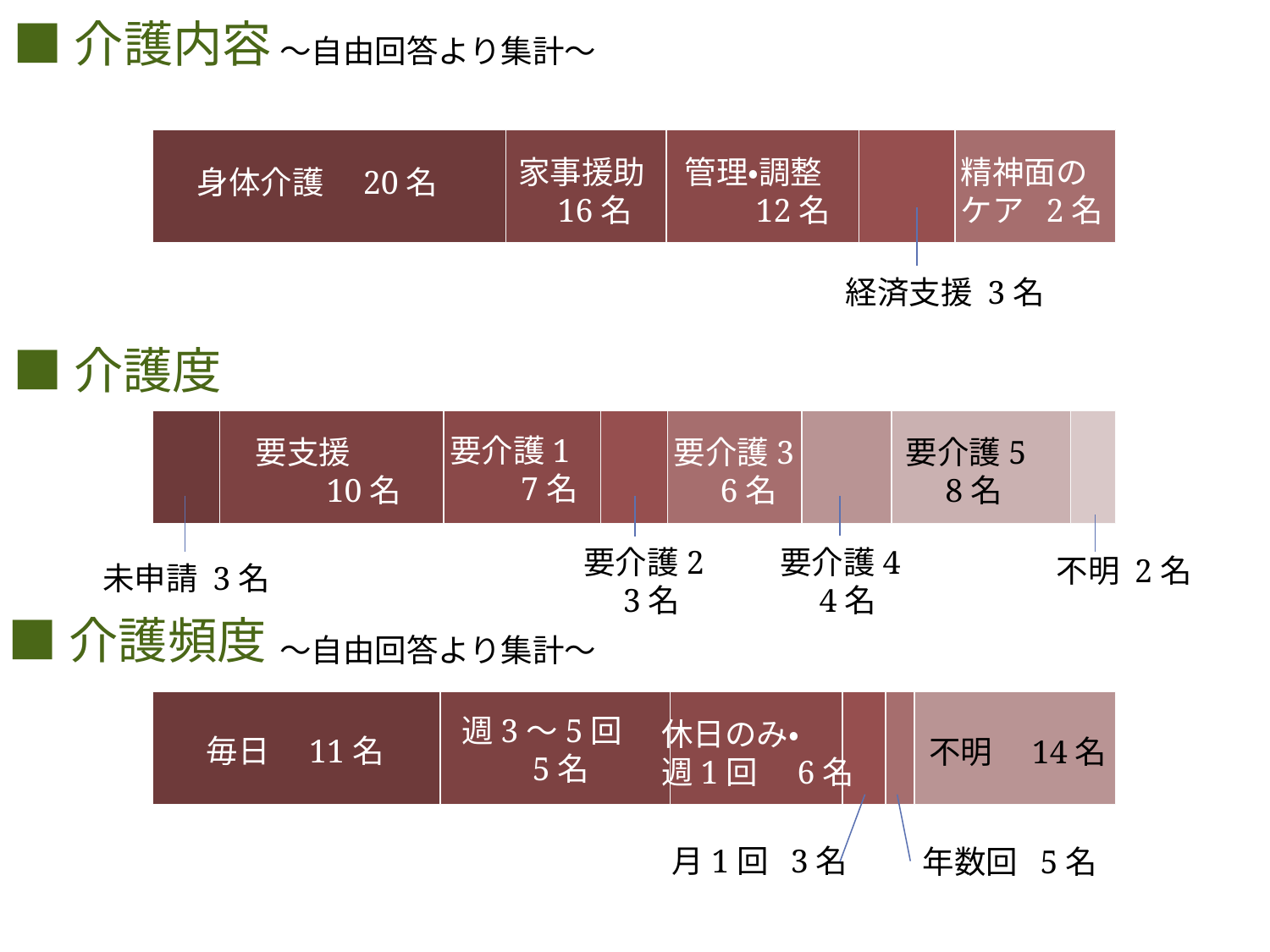
In the 介護内容 chart, what is the difference between 家事援助 and 管理・調整? 4名 In the 介護頻度 chart, what is the difference between 毎日 and 週3〜5回? 6名 In the 介護内容 chart, how many people are in the 身体介護 category? 20名 In the 介護内容 chart, which category has the lowest value? 精神面のケア In the 介護頻度 chart, how many people answered 不明? 14名 In the 介護度 chart, which is larger, 要介護1 or 要介護3? 要介護1 In the 介護度 chart, which category has the highest value? 要支援 What kind of chart is used for the 介護頻度 section? Stacked bar chart In the 介護頻度 chart, which category has the lowest value? 月1回 In the 介護度 chart, how many people are in the 要介護5 category? 8名 In the 介護度 chart, what is the total of all segments? 43名 In the 介護内容 chart, how many categories are shown? 5